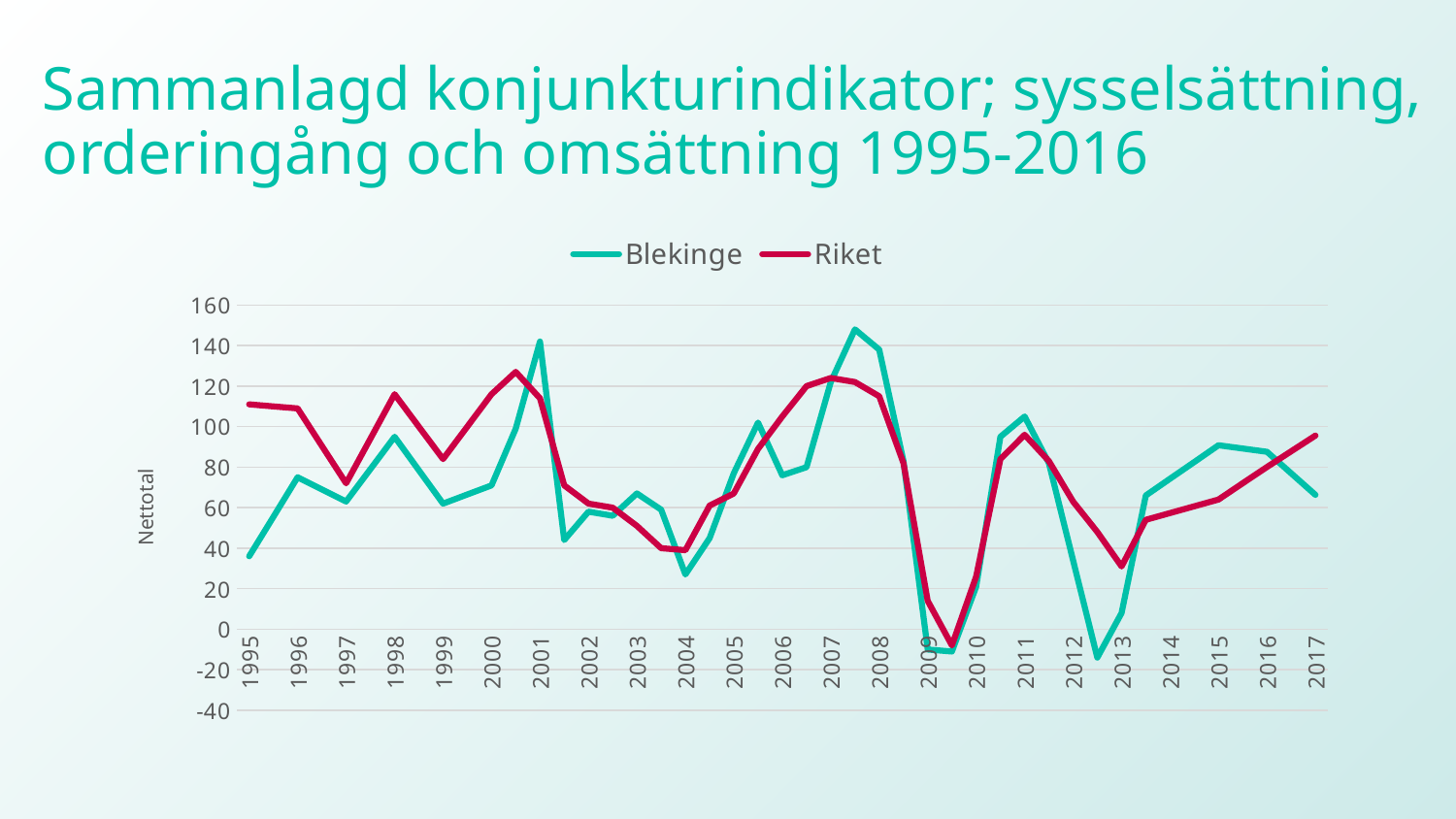
What kind of chart is shown on the slide? line chart What are the two series named in the legend? Blekinge and Riket What is the label on the vertical axis? Nettotal Is the value for Blekinge in 2004 greater or less than 40? less Is the value for Riket in 1995 greater or less than 100? greater Is the value for Riket in 2017 greater or less than 80? greater How many series does the legend list? 2 Does the Riket line rise or fall from 2013 to 2017? rise Which series reaches the highest value anywhere on the chart? Blekinge How many years are labelled on the horizontal axis? 23 In 1995, which series has the higher value, Blekinge or Riket? Riket